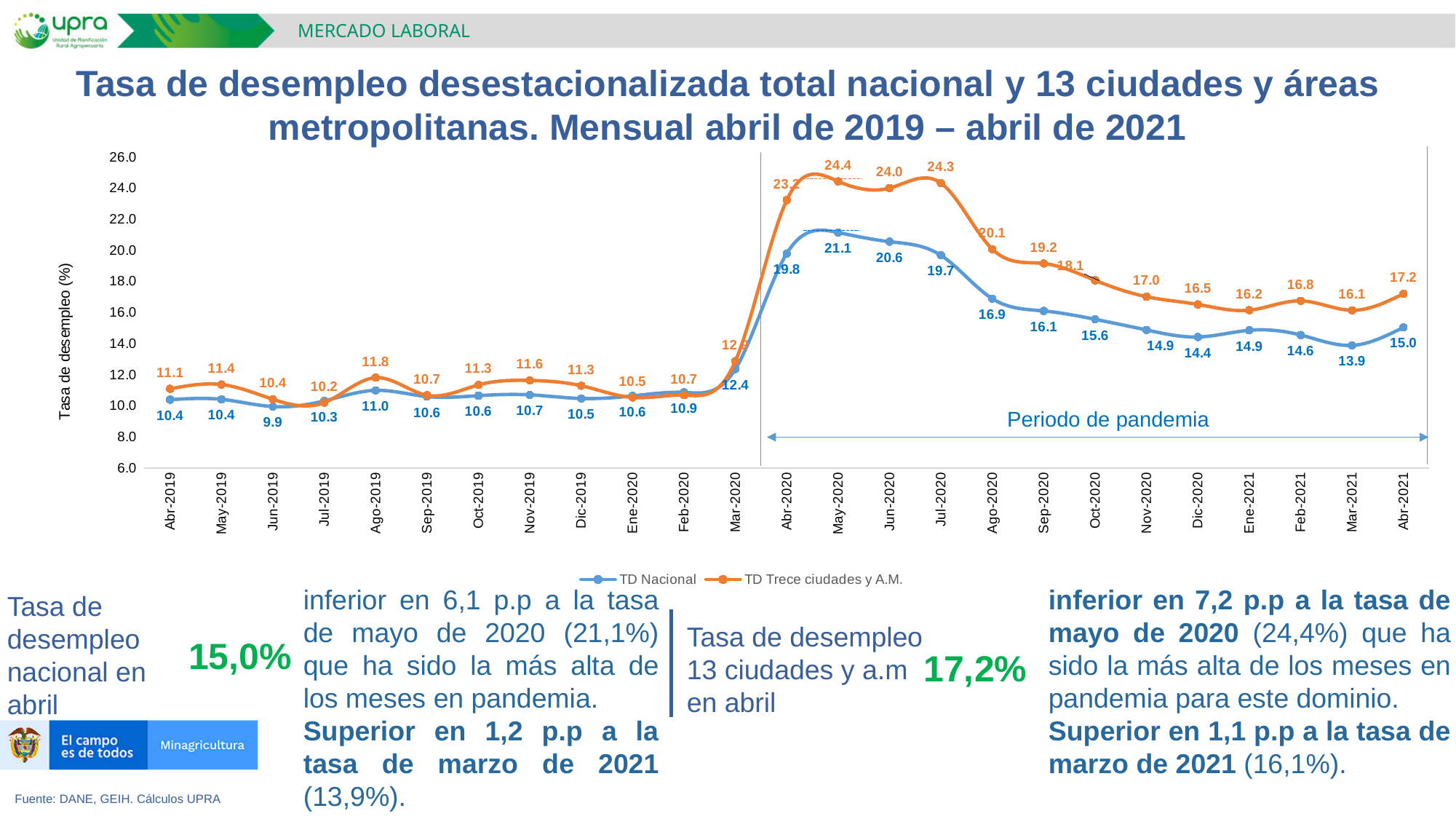
What is the TD Nacional value for Abr-2021? 15.0 Does the TD Nacional series rise or fall from May-2020 to Mar-2021? Fall Is the TD Trece ciudades y A.M. value for Ago-2020 greater or less than 18.0? greater What is the difference between the TD Trece ciudades y A.M. value for Abr-2021 and for Mar-2021? 1.1 In which month does the TD Nacional series have its lowest value? Jun-2019 How many months are plotted on the x axis? 25 Which series has the higher value in Jul-2020, TD Nacional or TD Trece ciudades y A.M.? TD Trece ciudades y A.M. What kind of chart is shown on the slide? Line chart In which month does the TD Nacional series reach its highest value? May-2020 What is the TD Trece ciudades y A.M. value for May-2020? 24.4 What is the TD Nacional value for Jun-2019? 9.9 How many series does the legend list? 2